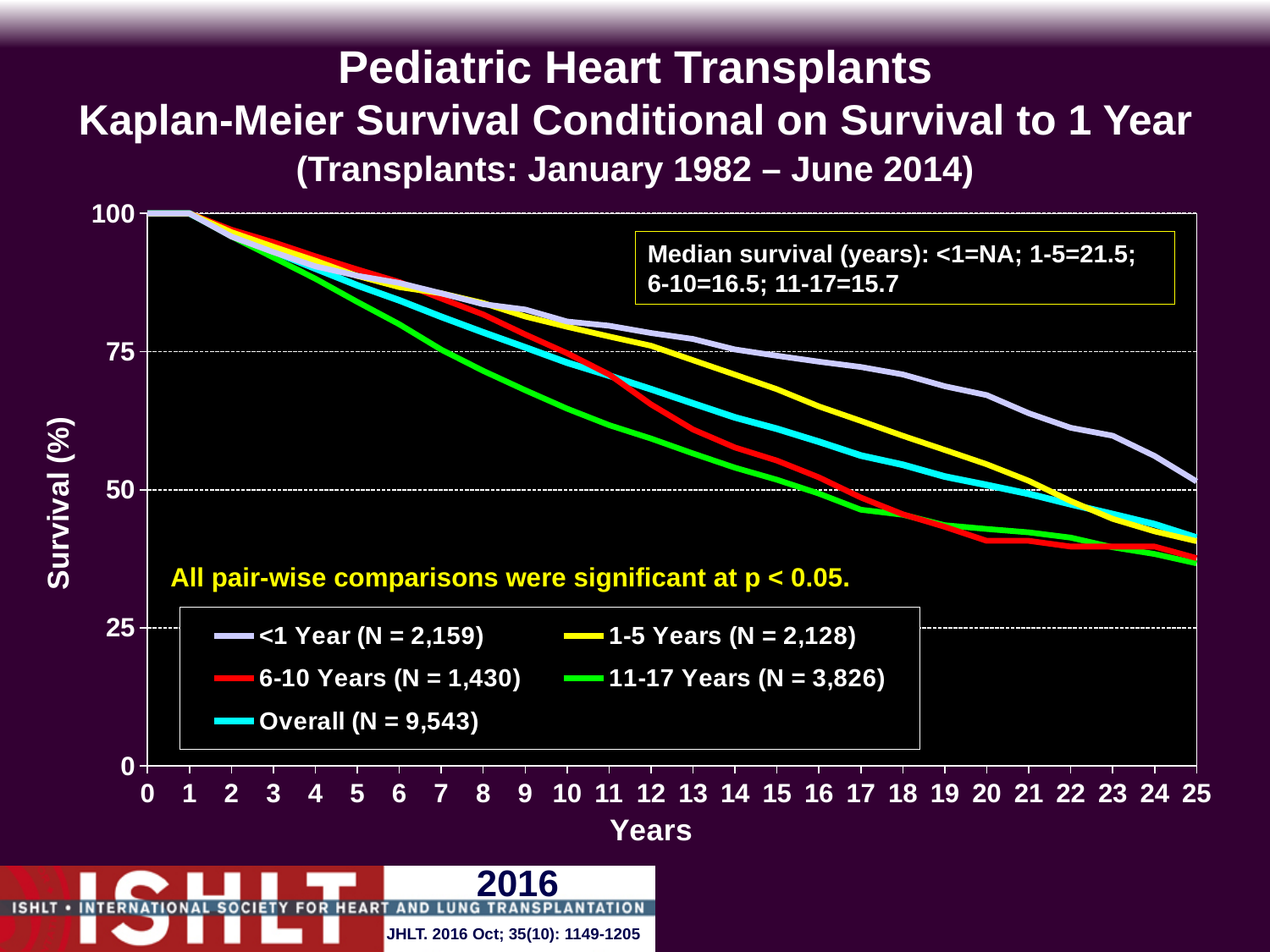
What kind of chart is shown on the slide? Line chart What is the N for the 6-10 Years group shown in the legend? 1,430 Which group has a median survival listed as NA? <1 Year What is the N for the Overall group shown in the legend? 9,543 Is the survival for the <1 Year group at 15 years greater or less than 50? greater What is the median survival in years for the 11-17 Years group? 15.7 Which group has the lowest survival at 10 years? 11-17 Years How many series does the legend list? 5 Is the survival for the 11-17 Years group at 10 years greater or less than 75? less Which group has the highest survival at 20 years? <1 Year What is the median survival in years for the 1-5 Years group? 21.5 Do the survival curves rise or fall as the years increase? Fall